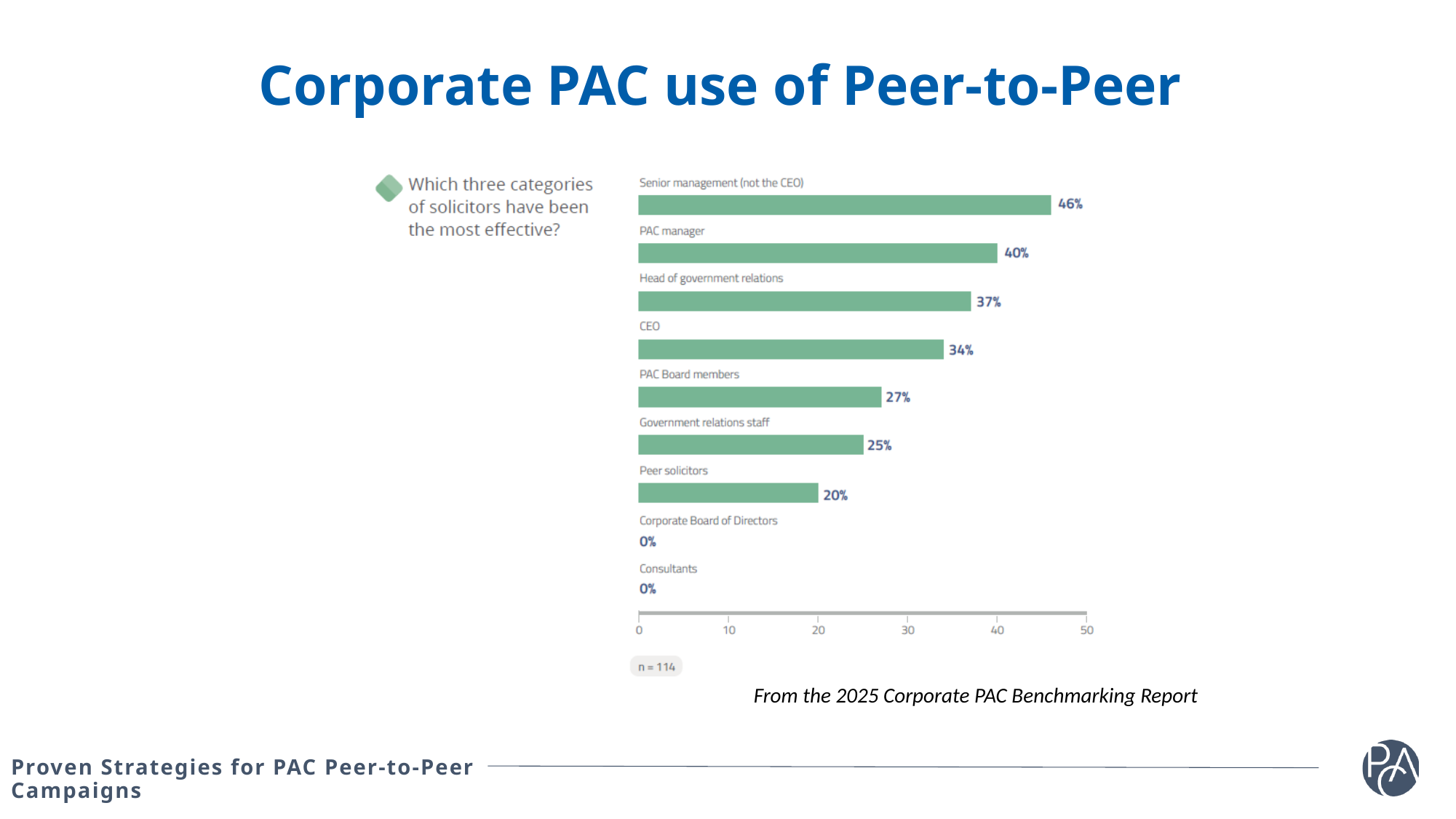
What question does the chart answer, according to the text beside it? Which three categories of solicitors have been the most effective? Which is larger, the value for PAC manager or the value for CEO? PAC manager What percentage is shown for PAC manager? 40% What kind of chart is shown on the slide? Bar chart What percentage is shown for Consultants? 0% How many categories are shown in the chart? 9 What percentage is shown for Peer solicitors? 20% What is the sample size (n) noted below the chart? n = 114 Which category has the highest percentage? Senior management (not the CEO) What is the difference in percentage points between PAC Board members and Government relations staff? 2 What percentage is shown for Senior management (not the CEO)? 46% What is the difference in percentage points between Head of government relations and CEO? 3